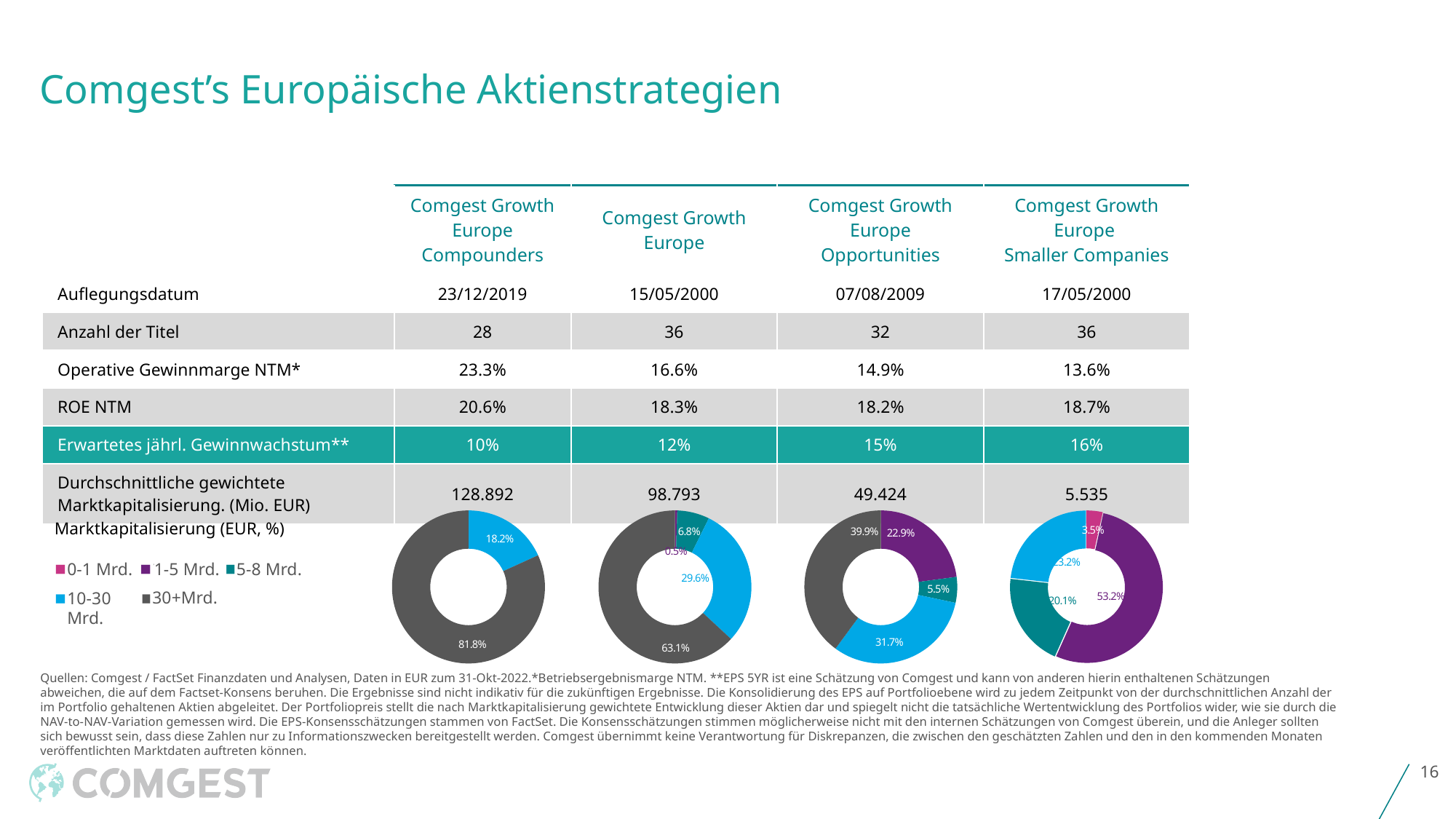
In the Comgest Growth Europe donut chart, what share is in the 10-30 Mrd. bucket? 29.6% How many market-cap buckets does the legend for the Marktkapitalisierung charts list? 5 In the Comgest Growth Europe Opportunities donut chart, which market-cap bucket has the smallest share? 5-8 Mrd. What type of chart is used to show the market capitalisation breakdown (Marktkapitalisierung) for each strategy? Donut (pie) chart In the Comgest Growth Europe donut chart, what share of market capitalisation is in the 30+ Mrd. bucket? 63.1% In the Comgest Growth Europe Smaller Companies donut chart, which market-cap bucket has the smallest share? 0-1 Mrd. In the Comgest Growth Europe Smaller Companies donut chart, what share is in the 1-5 Mrd. bucket? 53.2% In the Comgest Growth Europe Compounders donut chart, what share of market capitalisation is in the 30+ Mrd. bucket? 81.8% In the Comgest Growth Europe Opportunities donut chart, which market-cap bucket has the largest share? 30+ Mrd. In the Comgest Growth Europe Compounders donut chart, what is the difference between the 30+ Mrd. share and the 10-30 Mrd. share? 63.6 percentage points In the Comgest Growth Europe Opportunities donut chart, what share is in the 1-5 Mrd. bucket? 22.9% In the Comgest Growth Europe Compounders donut chart, what share is in the 10-30 Mrd. bucket? 18.2%